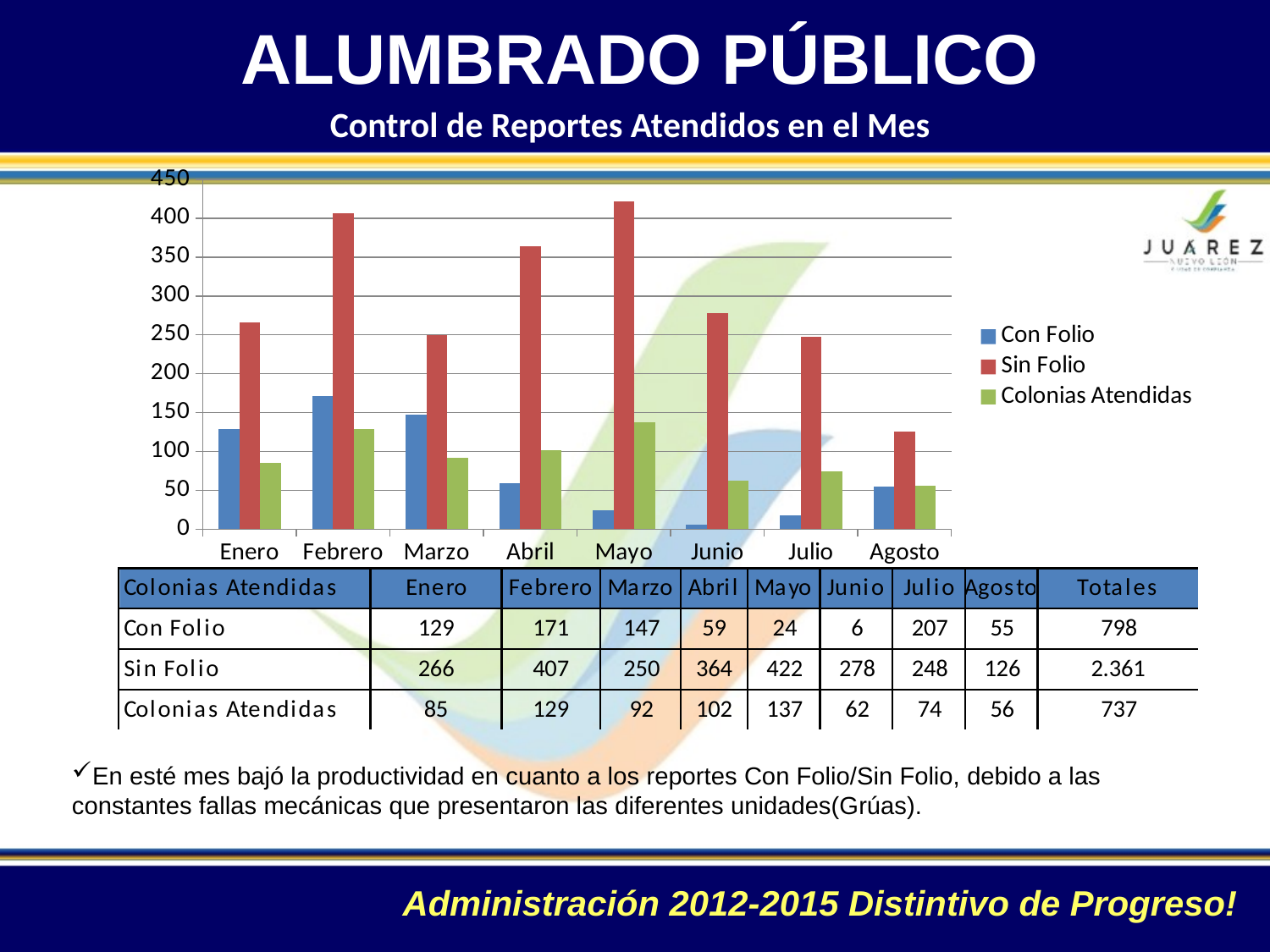
How many series does the chart legend list? 3 How many months are shown on the x axis of the chart? 8 What is the Colonias Atendidas value for Abril? 102 What kind of chart is shown on the slide? bar chart What is the difference between the Sin Folio and Con Folio values for Enero? 137 Is the Sin Folio value for Febrero greater or less than 400? greater Which series is shown in red in the chart? Sin Folio In which month is the Sin Folio value highest? Mayo Which is larger in Marzo, Con Folio or Colonias Atendidas? Con Folio What is the Sin Folio value for Mayo? 422 In which month is the Colonias Atendidas value lowest? Agosto What is the Con Folio value for Febrero? 171